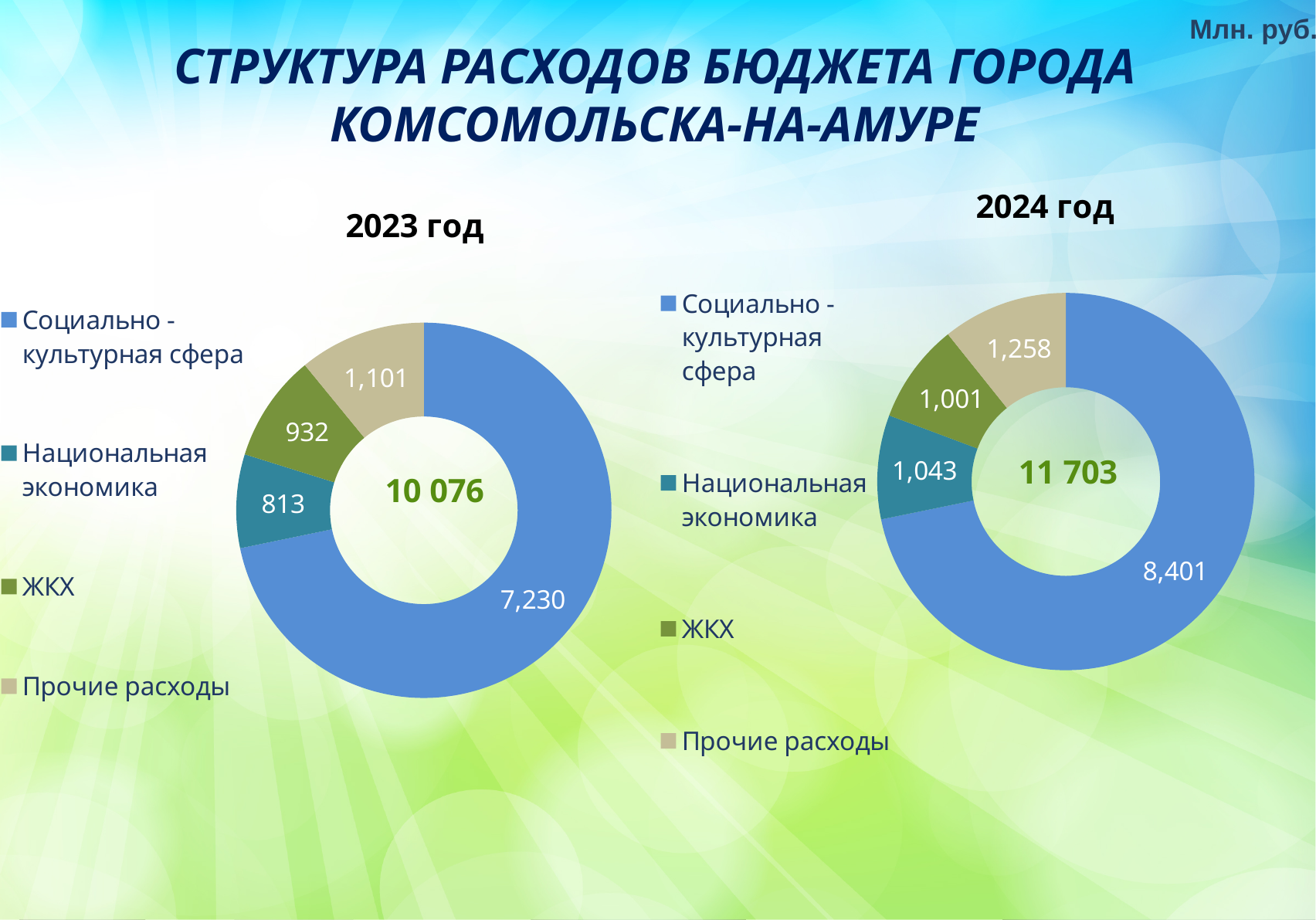
In the 2023 год chart, what is the value for Социально-культурная сфера? 7,230 In the 2024 год chart, what is the value for Национальная экономика? 1,043 In the 2024 год chart, what is the value for ЖКХ? 1,001 In the 2023 год chart, which category has the smallest value? Национальная экономика In the 2024 год chart, which category has the largest value? Социально-культурная сфера In the 2023 год chart, what is the value for Прочие расходы? 1,101 What is the difference between the Социально-культурная сфера value in the 2024 год chart and in the 2023 год chart? 1,171 What type of chart is used for the 2023 год data? Doughnut (pie) chart How many categories does the 2023 год chart show? 4 In the 2024 год chart, which is larger: Национальная экономика or ЖКХ? Национальная экономика What total is shown in the centre of the 2024 год chart? 11 703 In the 2023 год chart, what is the difference between Прочие расходы and ЖКХ? 169